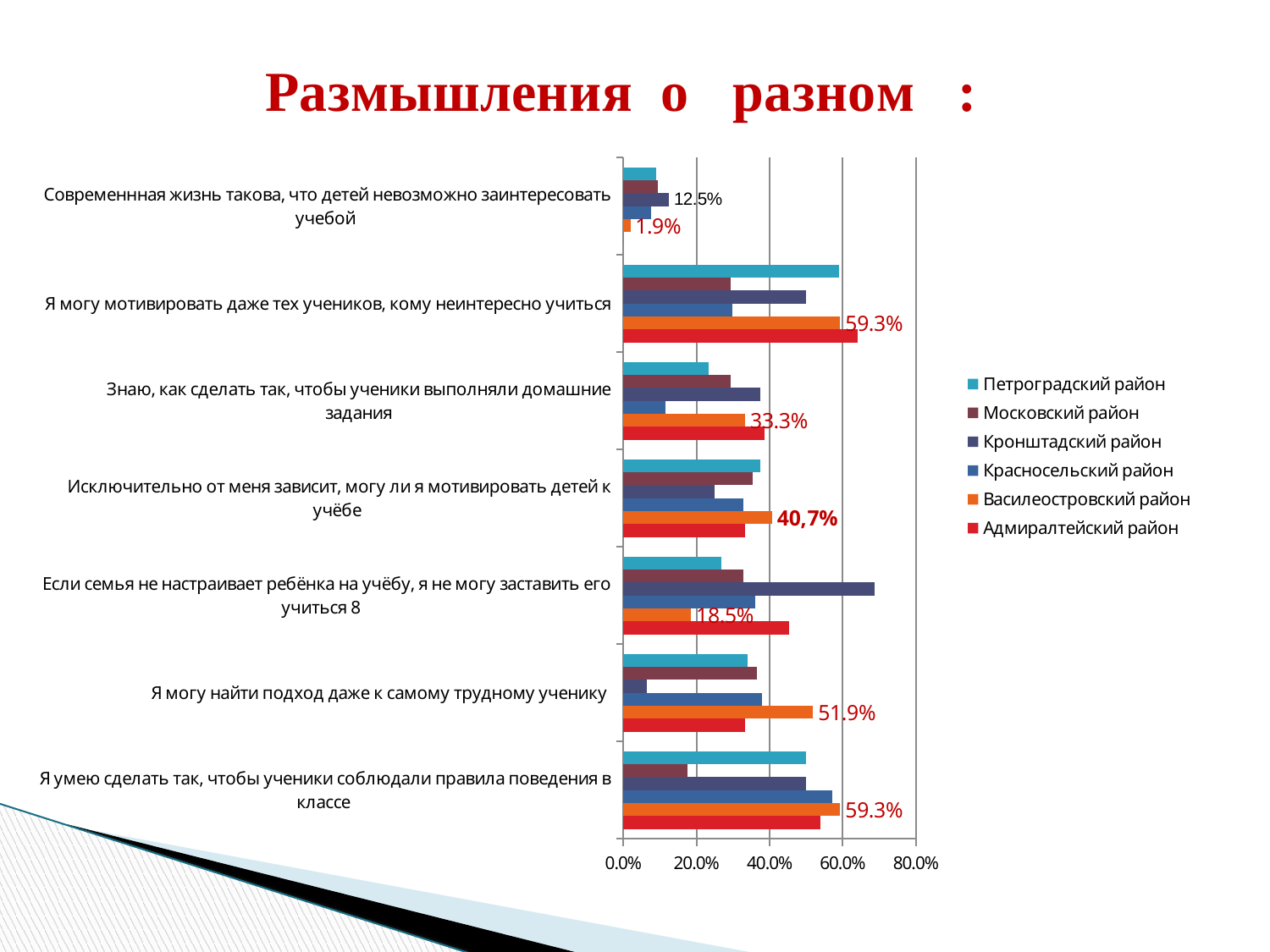
What is the difference between the Василеостровский район values for "Я могу найти подход даже к самому трудному ученику" and "Если семья не настраивает ребёнка на учёбу, я не могу заставить его учиться"? 33.4% Is the value for Кронштадский район for the statement "Если семья не настраивает ребёнка на учёбу, я не могу заставить его учиться" greater or less than 60.0%? greater What is the value for Василеостровский район for the statement "Современнная жизнь такова, что детей невозможно заинтересовать учебой"? 1.9% What is the value for Василеостровский район for the statement "Если семья не настраивает ребёнка на учёбу, я не могу заставить его учиться"? 18.5% What is the value for Василеостровский район for the statement "Я могу найти подход даже к самому трудному ученику"? 51.9% How many series does the legend list? 6 What kind of chart is shown on the slide? bar chart What is the value for Василеостровский район for the statement "Знаю, как сделать так, чтобы ученики выполняли домашние задания"? 33.3% For the statement "Я могу мотивировать даже тех учеников, кому неинтересно учиться", which is larger: Петроградский район or Московский район? Петроградский район What is the value for Василеостровский район for the statement "Исключительно от меня зависит, могу ли я мотивировать детей к учёбе"? 40,7% For the statement "Если семья не настраивает ребёнка на учёбу, я не могу заставить его учиться", which district has the highest value? Кронштадский район How many statement categories are plotted on the chart? 7